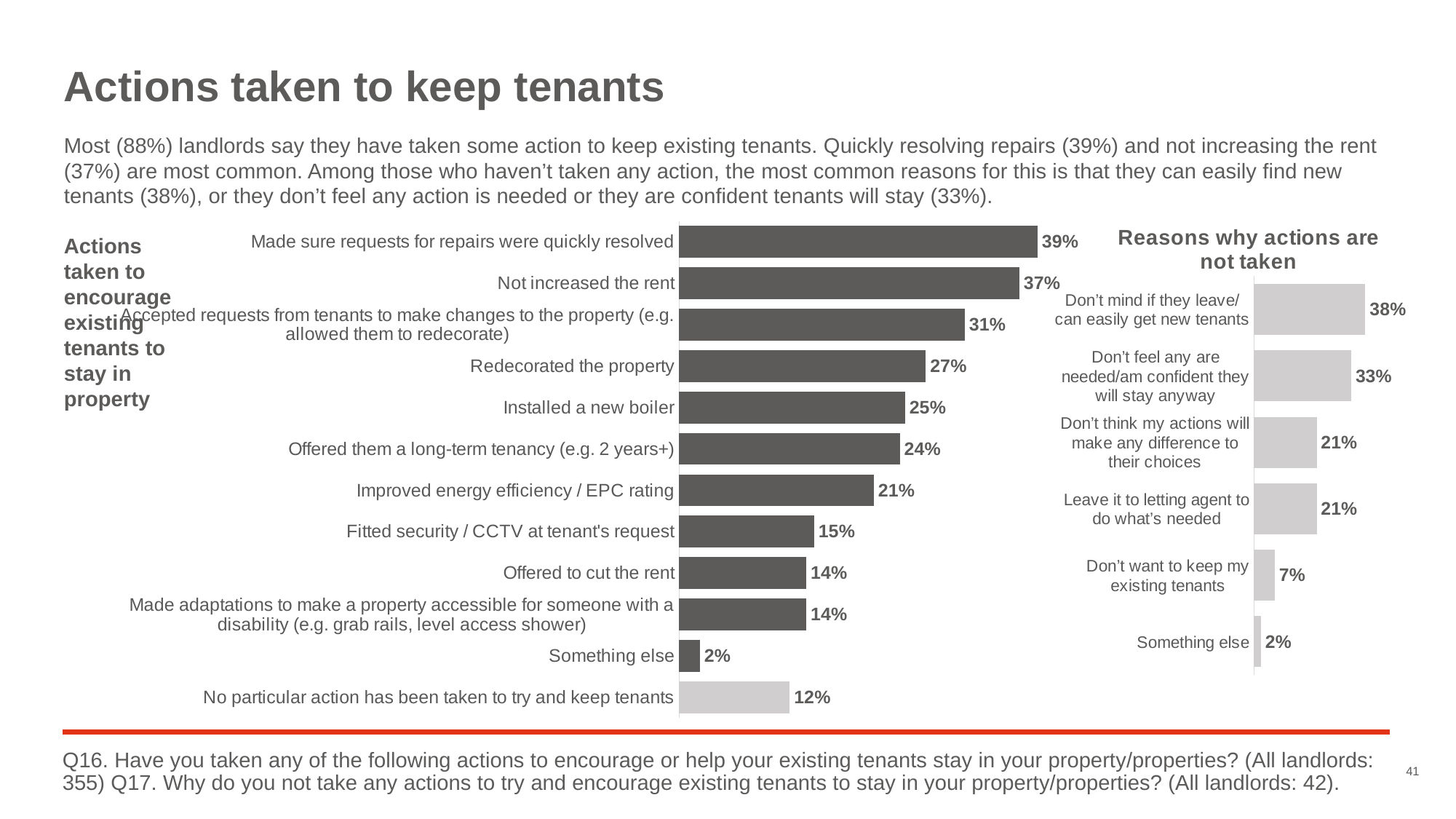
In the left chart on actions taken to encourage existing tenants to stay, what is the difference between 'Not increased the rent' and 'Offered to cut the rent'? 23 percentage points In the 'Reasons why actions are not taken' chart, what percentage of landlords say they don't want to keep their existing tenants? 7% How many categories are shown in the 'Reasons why actions are not taken' chart? 6 In the 'Reasons why actions are not taken' chart, what is the difference between the highest reason and 'Don't feel any are needed/am confident they will stay anyway'? 5 percentage points In the left chart on actions taken to encourage existing tenants to stay, what percentage of landlords installed a new boiler? 25% In the left chart on actions taken to encourage existing tenants to stay, which action has the highest percentage? Made sure requests for repairs were quickly resolved In the 'Reasons why actions are not taken' chart, what percentage of landlords say they don't mind if tenants leave / can easily get new tenants? 38% In the left chart on actions taken to encourage existing tenants to stay, what percentage of landlords made sure requests for repairs were quickly resolved? 39% In the left chart on actions taken to encourage existing tenants to stay, which category has the lowest percentage? Something else What type of chart is the 'Reasons why actions are not taken' chart? Bar chart How many categories are shown in the left chart on actions taken to encourage existing tenants to stay? 12 In the left chart on actions taken to encourage existing tenants to stay, which is larger: 'Redecorated the property' or 'Offered them a long-term tenancy (e.g. 2 years+)'? Redecorated the property